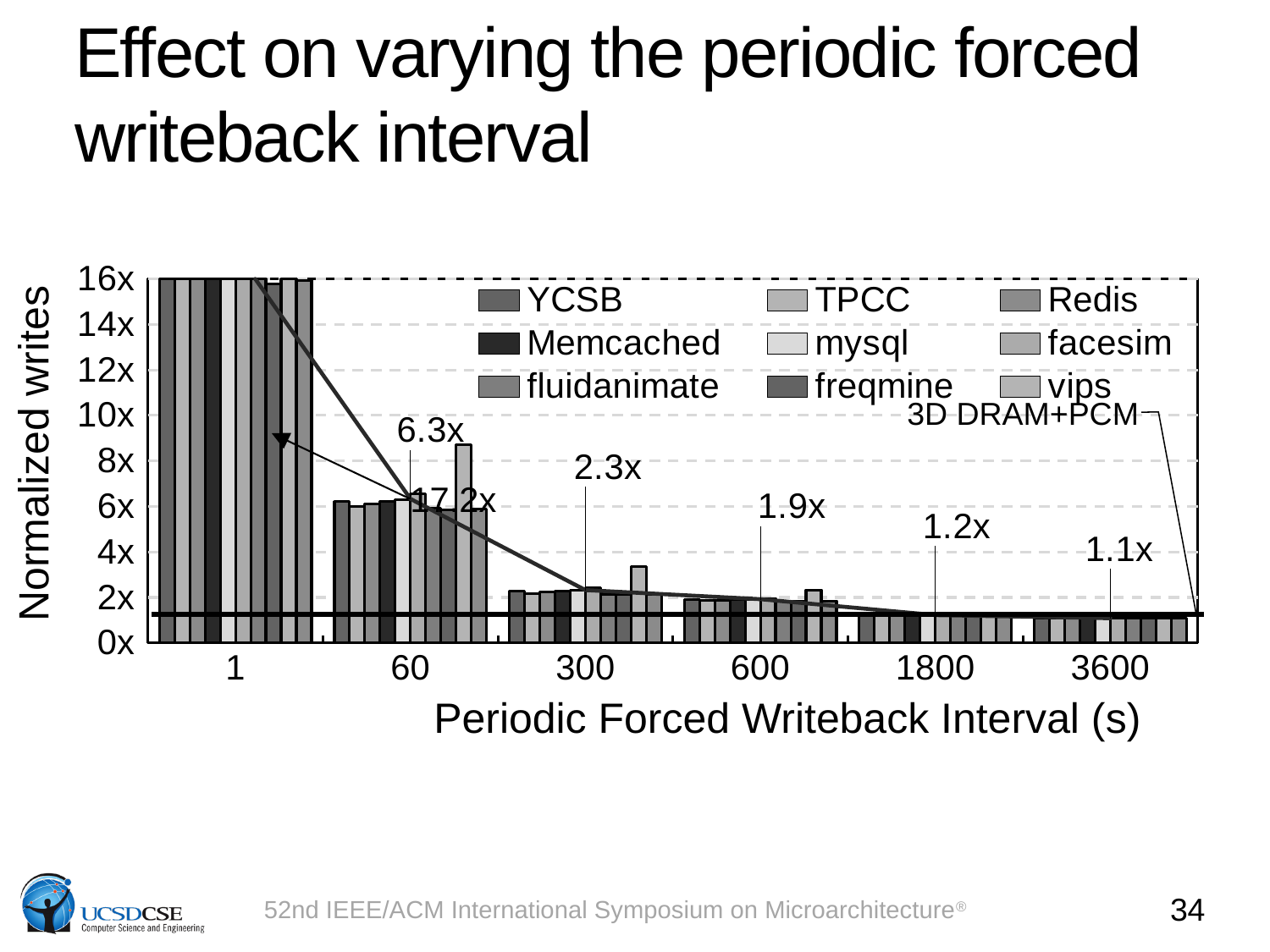
What value is annotated above the bars for the 1800 s interval? 1.2x Which interval has the highest annotated value? 1 What value is annotated above the bars for the 300 s interval? 2.3x What kind of chart is shown on the slide? bar chart What value is annotated above the bars for the 60 s interval? 6.3x Which interval has the lowest annotated value? 3600 How many series does the legend list? 9 How many periodic forced writeback interval categories are shown on the x axis? 6 Are the bars for the 3600 s interval greater or less than 2x? less Do the annotated values rise or fall as the writeback interval increases along the x axis? fall What is the difference between the annotated values for the 1 s and 60 s intervals? 10.9x What is the label of the horizontal reference line on the chart? 3D DRAM+PCM